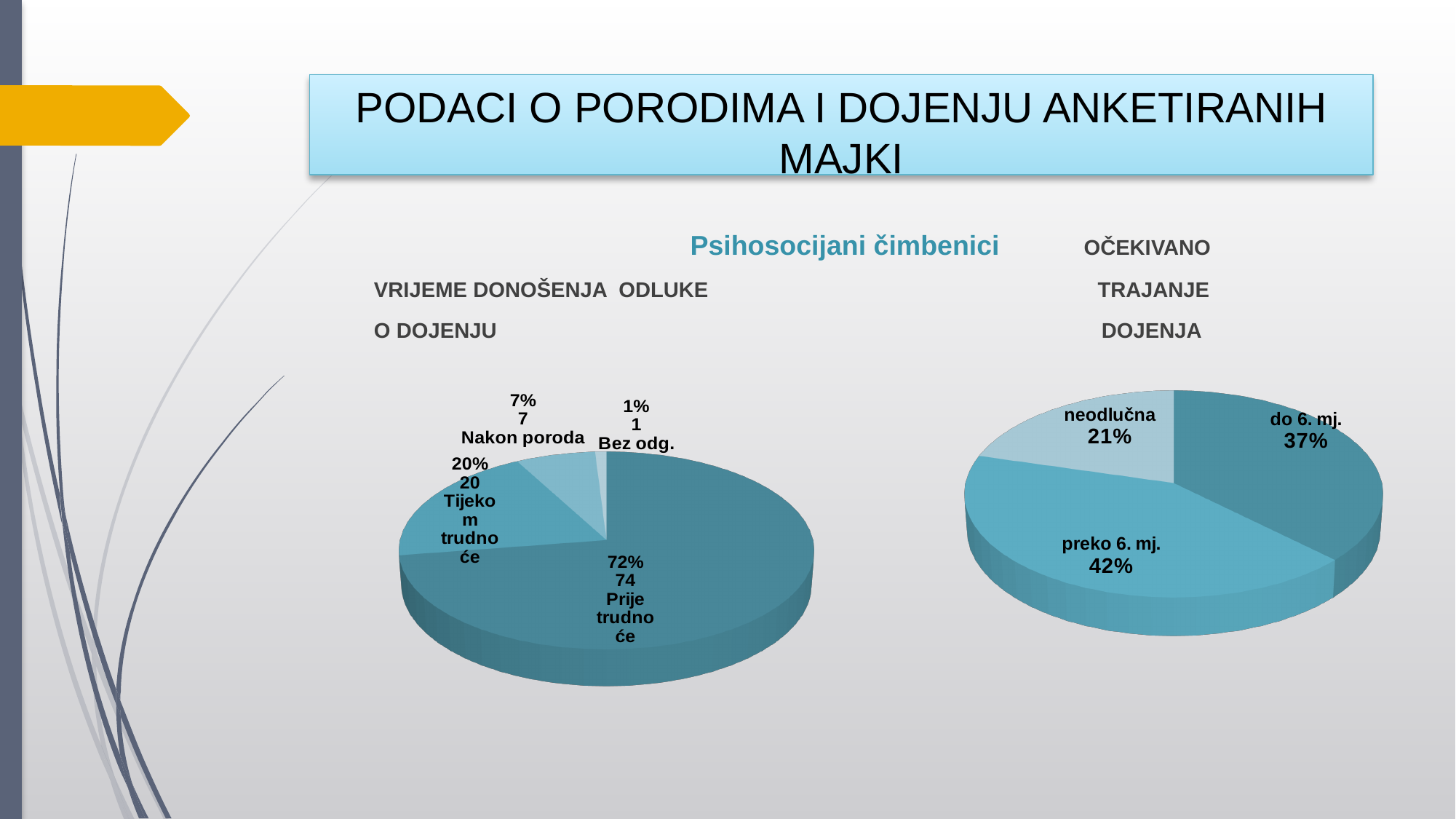
In the right pie chart, what percentage is shown for 'neodlučna'? 21% In the left pie chart, which category has the largest slice? Prije trudnoće In the left pie chart, what is the difference in count between 'Prije trudnoće' and 'Tijekom trudnoće'? 54 In the left pie chart, which category has the smallest slice? Bez odg. In the right pie chart, which is larger: 'do 6. mj.' or 'preko 6. mj.'? preko 6. mj. In the right pie chart (Očekivano trajanje dojenja), what percentage is shown for 'preko 6. mj.'? 42% What type of chart is used on the right side of the slide? Pie chart In the left pie chart (Vrijeme donošenja odluke o dojenju), what percentage is shown for 'Prije trudnoće'? 72% In the left pie chart, how many slices are there? 4 In the left pie chart, what count is shown for 'Tijekom trudnoće'? 20 In the right pie chart, what is the difference in percentage points between 'preko 6. mj.' and 'neodlučna'? 21 In the left pie chart, what percentage is shown for 'Nakon poroda'? 7%